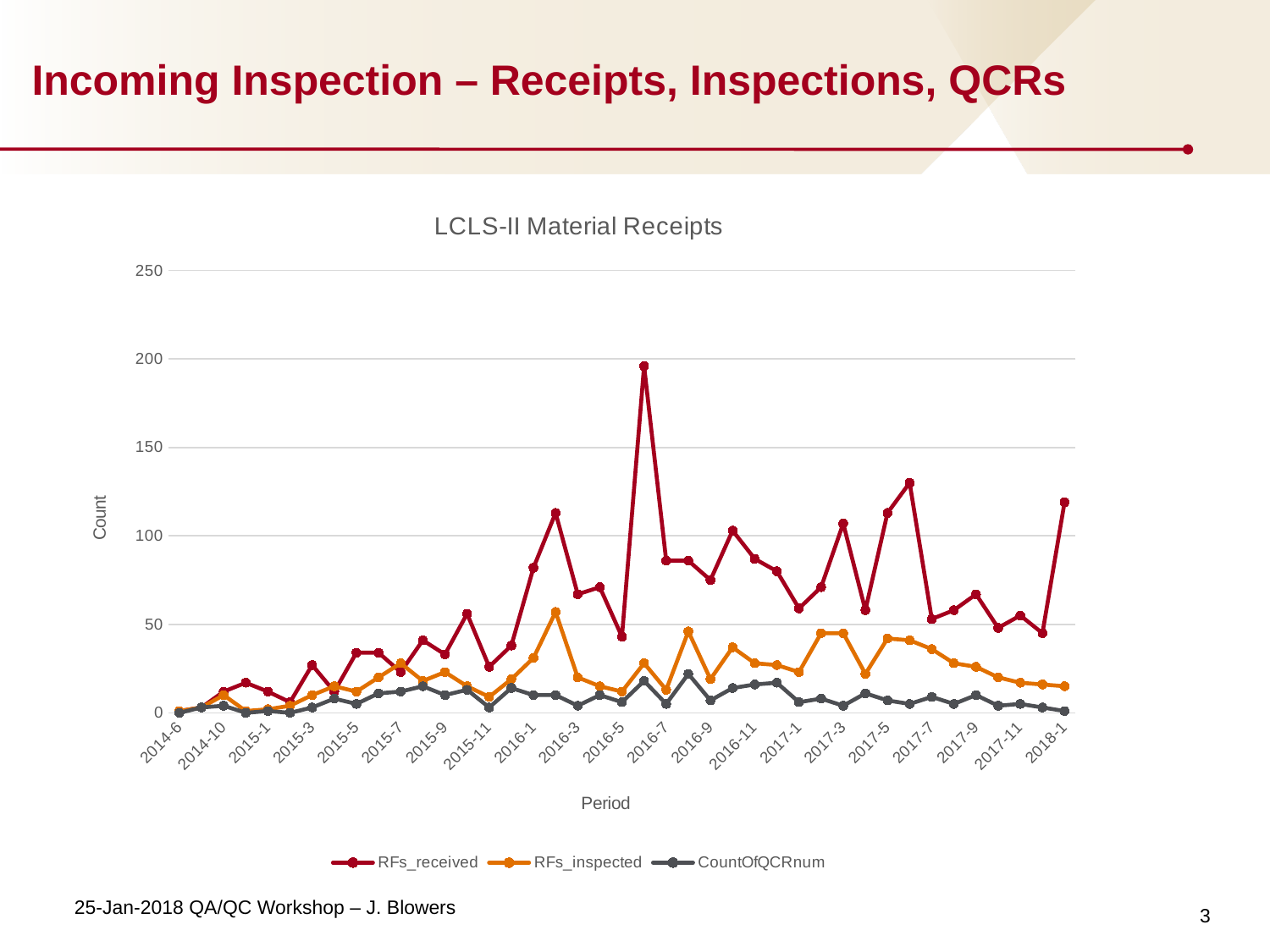
Is the value for RFs_received at 2017-5 greater or less than 100? greater Is the value for CountOfQCRnum at 2016-7 greater or less than 50? less How many series does the legend list? 3 At 2016-7, which is larger: RFs_received or RFs_inspected? RFs_received What is the title of the chart? LCLS-II Material Receipts Does RFs_received generally rise or fall from 2014-6 to 2016-7? rise Is the value for RFs_inspected at 2016-3 greater or less than 50? less What is the label of the y axis? Count What kind of chart is shown on the slide? line chart Which series has the highest values overall? RFs_received